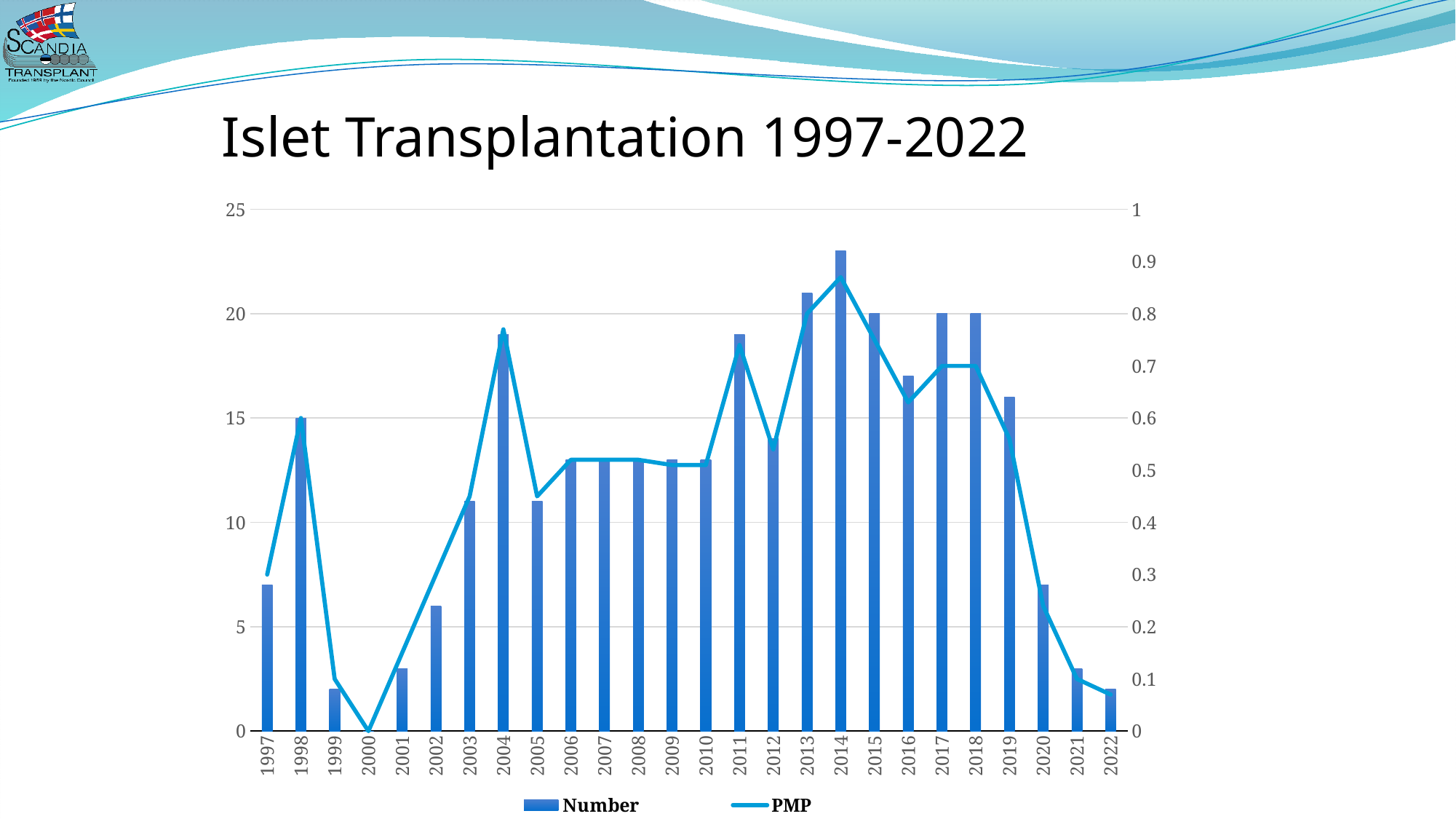
How many years are shown on the x axis? 26 What is the PMP value for 2017? 0.7 What kind of chart is shown on the slide? Combination bar and line chart What is the difference between the Number values for 2015 and 1998? 5 Is the Number value for 2014 greater or less than 20? greater Which year has the larger Number value, 2011 or 2012? 2011 Which year has the lowest Number of islet transplantations? 2000 What is the Number value for 2015? 20 Which year has the highest Number of islet transplantations? 2014 What is the Number value for 1998? 15 Is the Number value for 1999 greater or less than 5? less How many series does the legend list? 2